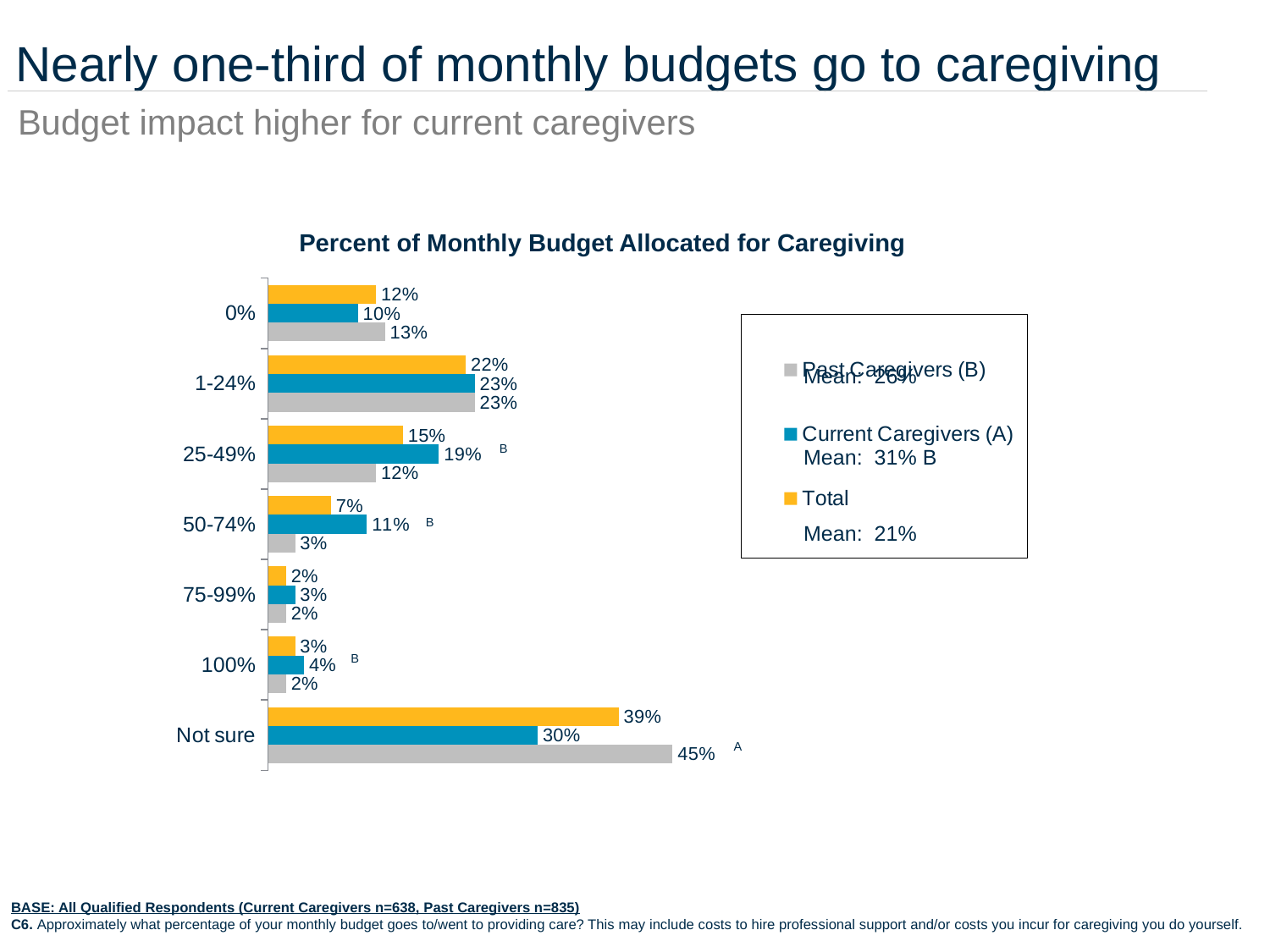
What type of chart is shown on the slide? Bar chart Which category has the highest Past Caregivers (B) value? Not sure How many series does the legend list? 3 What is the Current Caregivers (A) value for the 50-74% category? 11% What is the mean monthly budget allocation shown for Current Caregivers (A)? 31% What is the Total value for the 'Not sure' category? 39% What is the Past Caregivers (B) value for the 0% category? 13% What percentage of Current Caregivers (A) allocate 25-49% of their monthly budget to caregiving? 19% For the 25-49% category, which is larger: the Current Caregivers (A) value or the Past Caregivers (B) value? Current Caregivers (A) What is the difference between the Past Caregivers (B) and Current Caregivers (A) values for 'Not sure'? 15% How many categories are shown on the chart? 7 Which category has the lowest Total value? 75-99%